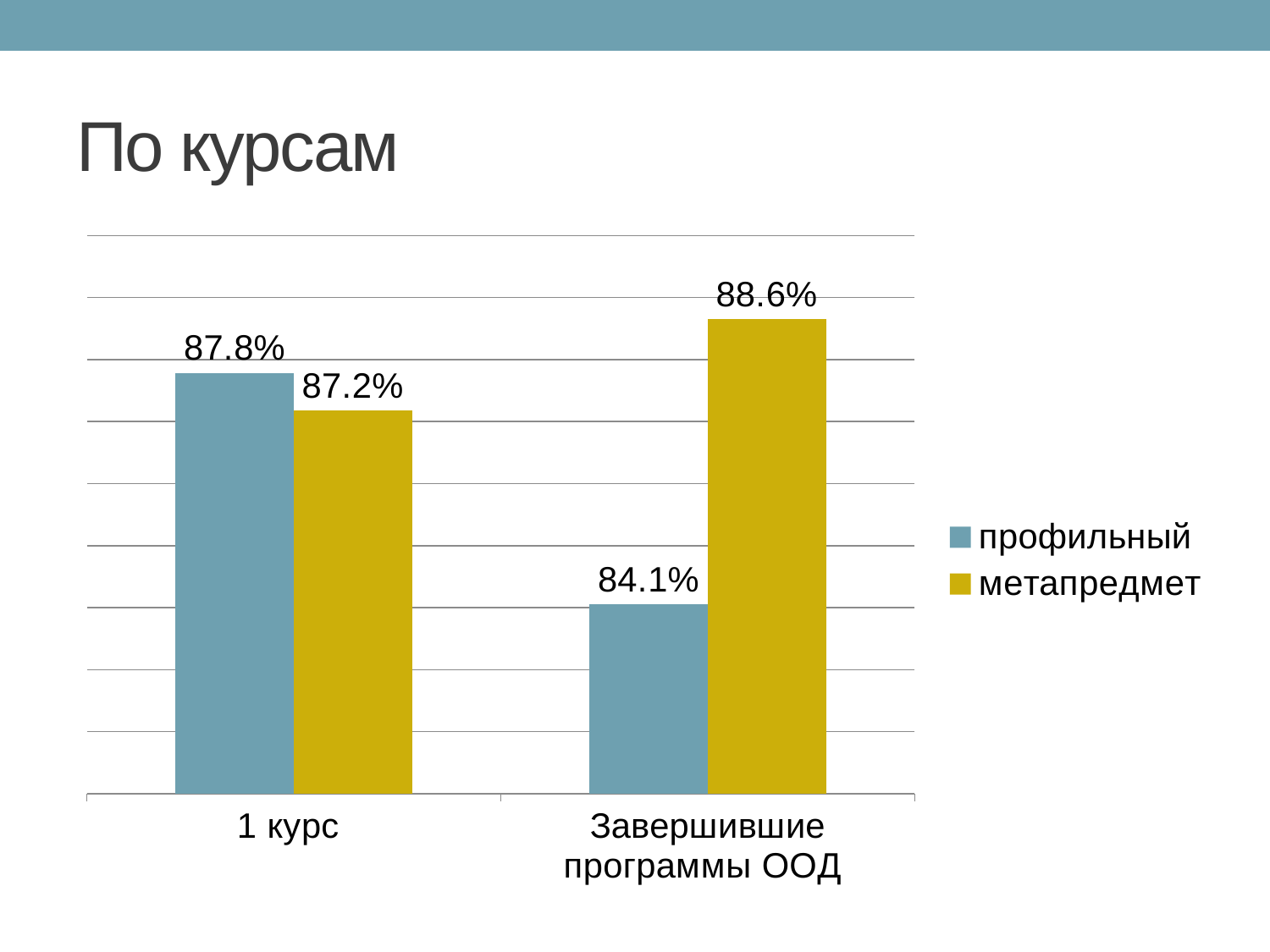
What is the value for метапредмет in the Завершившие программы ООД category? 88.6% How many categories are shown on the x axis? 2 What is the value for метапредмет in the 1 курс category? 87.2% How many series does the legend list? 2 What is the difference between the профильный values for 1 курс and Завершившие программы ООД? 3.7% What is the value for профильный in the Завершившие программы ООД category? 84.1% Which category has the lowest value for the профильный series? Завершившие программы ООД What is the difference between the метапредмет and профильный values in the Завершившие программы ООД category? 4.5% In the 1 курс category, which series has the larger value, профильный or метапредмет? профильный What is the value for профильный in the 1 курс category? 87.8% Which category has the highest value for the метапредмет series? Завершившие программы ООД What kind of chart is shown on the slide? bar chart